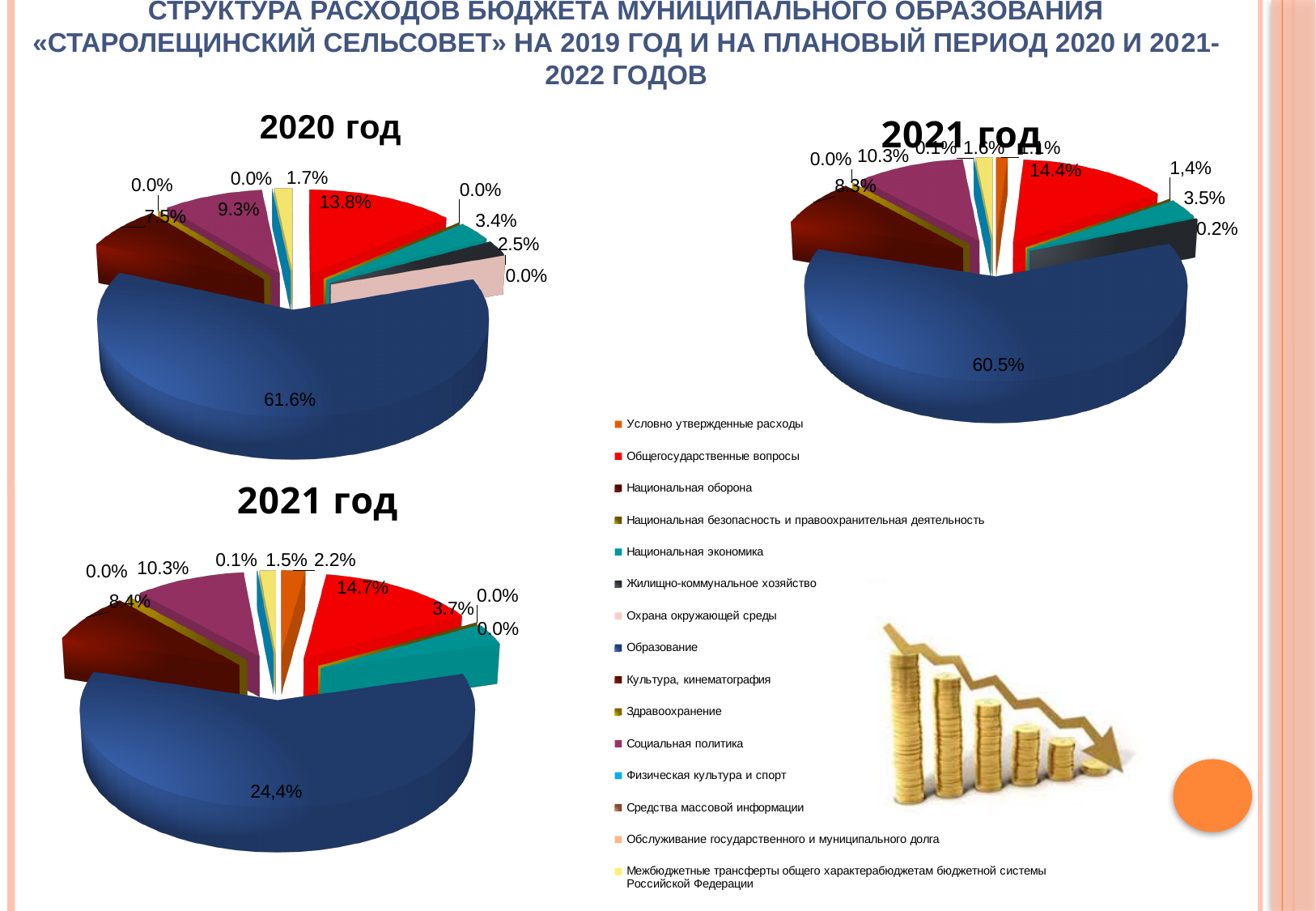
In the top-left chart "2020 год", what is the percentage shown on the largest (blue) slice? 61.6% How many categories does the legend list? 15 In the top-right chart "2021 год", is the largest slice greater or less than 50%? greater In the top-left chart "2020 год", is the red slice (13.8%) larger or smaller than the purple slice (9.3%)? larger In the top-right chart "2021 год", what is the percentage shown on the largest (blue) slice? 60.5% What kind of chart is the top-left chart titled "2020 год"? pie chart How many pie charts are shown on the slide? 3 In the bottom-left chart "2021 год", what is the percentage shown on the largest (blue) slice? 24,4% According to the legend, which category is represented by the dark blue colour? Образование In the top-left chart "2020 год", what is the percentage shown on the red slice? 13.8% In the top-left chart "2020 год", what is the difference between the largest slice (61.6%) and the red slice (13.8%)? 47.8% What is the title of the top-left chart? 2020 год